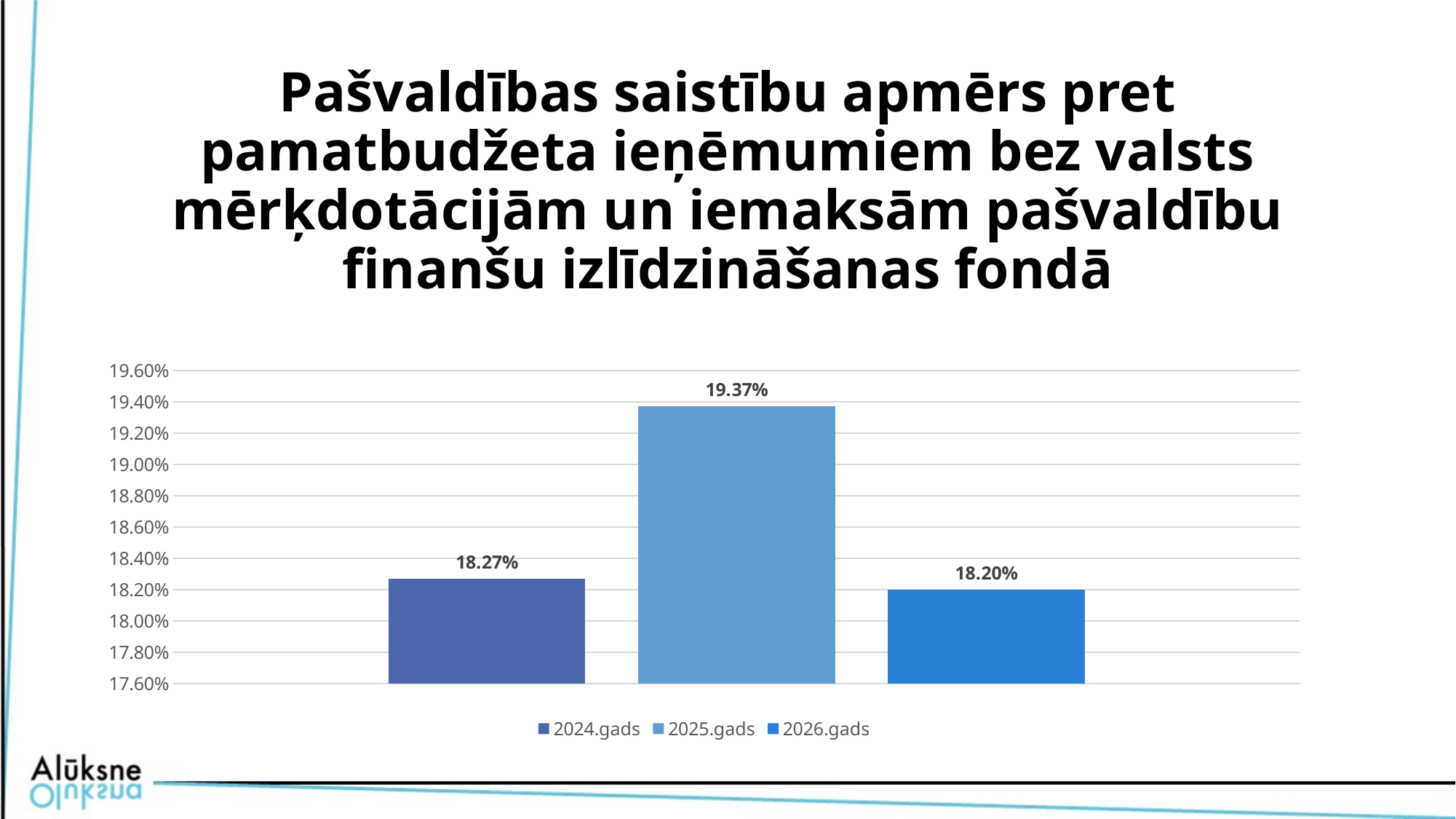
How many series does the legend list? 3 Which is larger, the value for 2024.gads or the value for 2026.gads? 2024.gads How many bars are plotted in the chart? 3 Which year has the highest value? 2025.gads What is the difference between the values for 2025.gads and 2024.gads? 1.10 percentage points What is the value for 2025.gads? 19.37% Is the value for 2025.gads greater or less than 19.00%? greater What is the difference between the values for 2024.gads and 2026.gads? 0.07 percentage points What is the value for 2026.gads? 18.20% What kind of chart is shown on the slide? Bar chart What is the value for 2024.gads? 18.27% Which year has the lowest value? 2026.gads